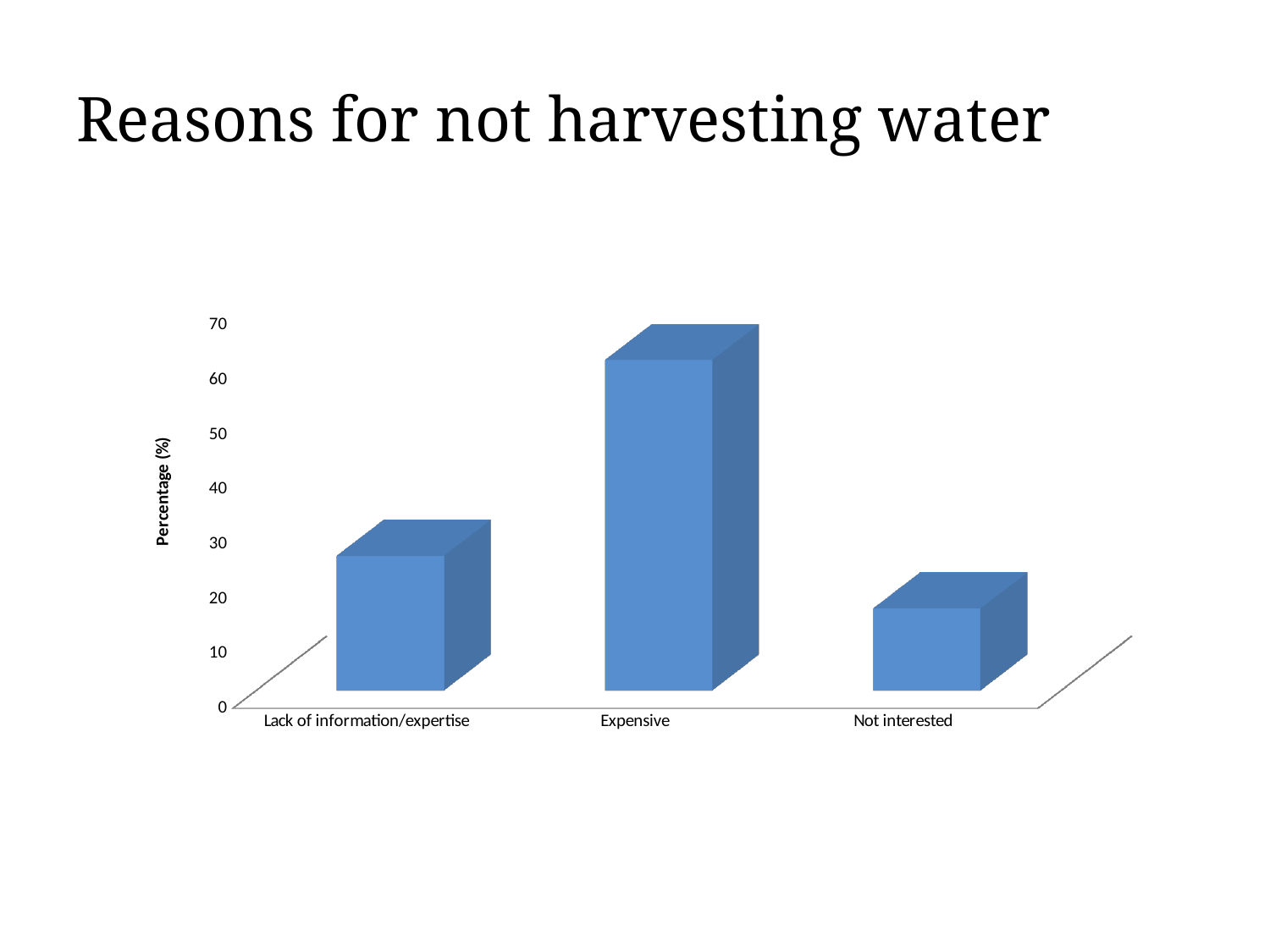
How many categories are shown on the x axis of the chart? 3 Is the value for Lack of information/expertise greater or less than 40? less What is the title of the slide containing the chart? Reasons for not harvesting water Is the value for Lack of information/expertise greater or less than 20? greater Is the value for Expensive greater or less than 50? greater Which is larger, the value for Expensive or the value for Lack of information/expertise? Expensive What kind of chart is shown on the slide? bar chart Which reason has the highest percentage in the chart? Expensive What is the label on the vertical axis of the chart? Percentage (%) Which reason has the lowest percentage in the chart? Not interested Which is larger, the value for Lack of information/expertise or the value for Not interested? Lack of information/expertise